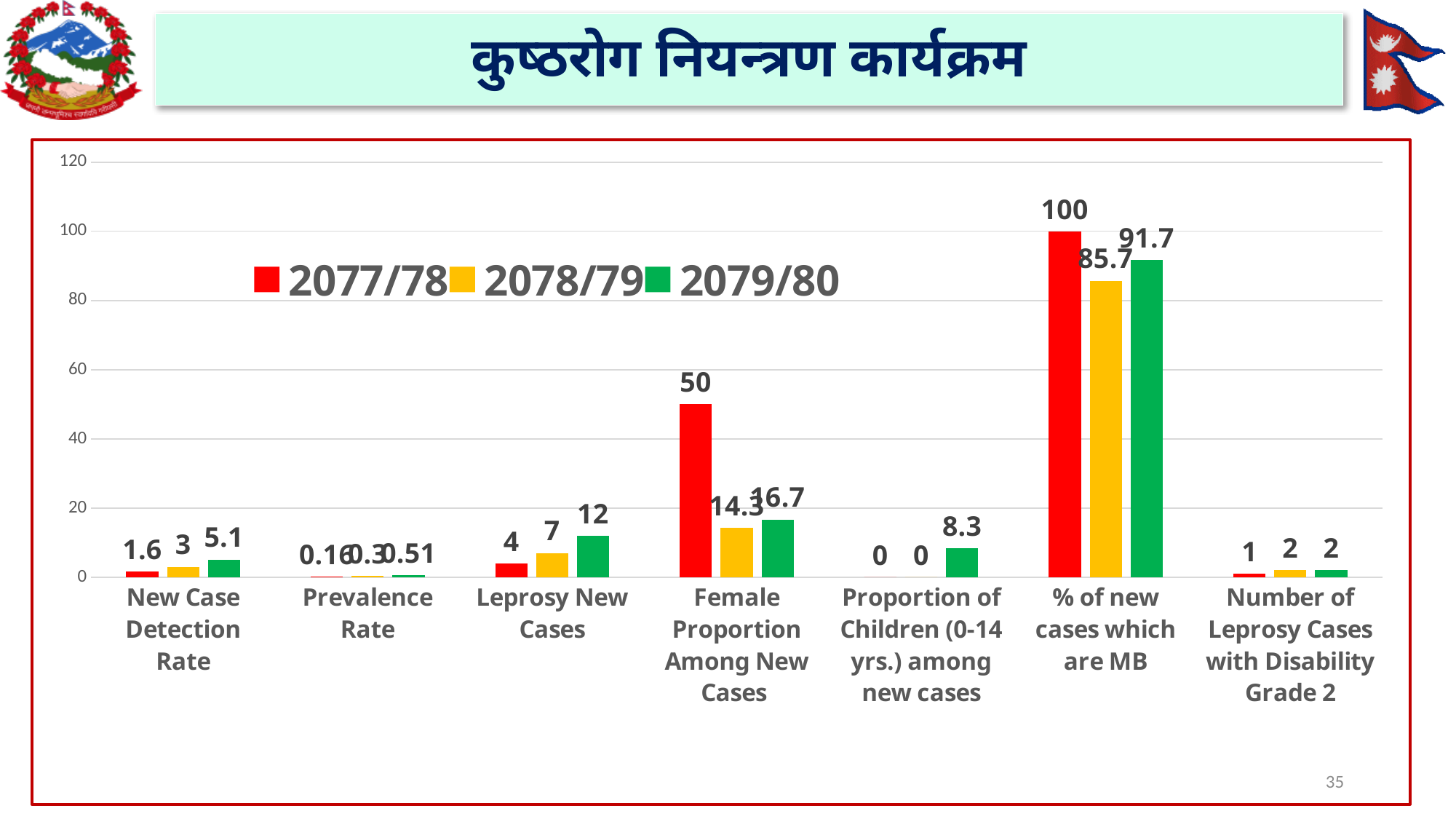
Which category has the highest value for the 2077/78 series? % of new cases which are MB What is the value for 2079/80 in the Proportion of Children (0-14 yrs.) among new cases category? 8.3 What kind of chart is shown on the slide? Bar chart What is the value for 2079/80 in the New Case Detection Rate category? 5.1 What is the difference between the 2079/80 and 2077/78 values for Leprosy New Cases? 8 How many series does the legend list? 3 Do the values for Leprosy New Cases rise or fall from 2077/78 to 2079/80? Rise What is the value for 2077/78 in the Female Proportion Among New Cases category? 50 Which is larger for Female Proportion Among New Cases: the 2078/79 value or the 2079/80 value? 2079/80 How many categories are shown on the x axis? 7 What is the difference between the 2077/78 and 2078/79 values for % of new cases which are MB? 14.3 What is the value for 2078/79 in the % of new cases which are MB category? 85.7